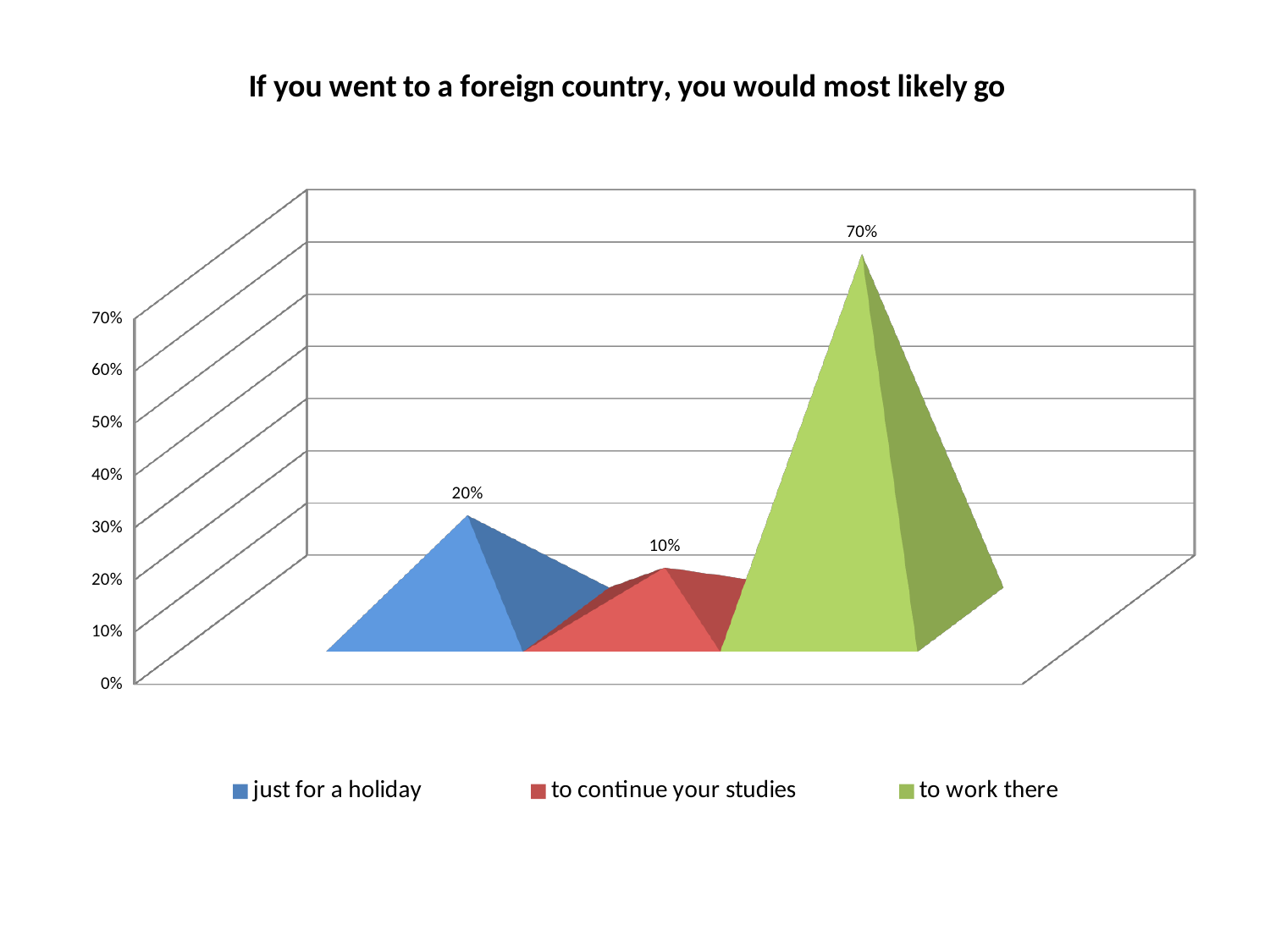
What is the difference between the values for "to work there" and "just for a holiday"? 50% Which category has the lowest value? to continue your studies What is the value for "to work there"? 70% Which is larger, the value for "just for a holiday" or the value for "to continue your studies"? just for a holiday What is the title of the chart? If you went to a foreign country, you would most likely go How many entries does the legend list? 3 What is the value for "just for a holiday"? 20% What is the value for "to continue your studies"? 10% How many categories are shown in the chart? 3 Which category has the highest value? to work there What kind of chart is shown on the slide? bar chart What is the difference between the values for "just for a holiday" and "to continue your studies"? 10%